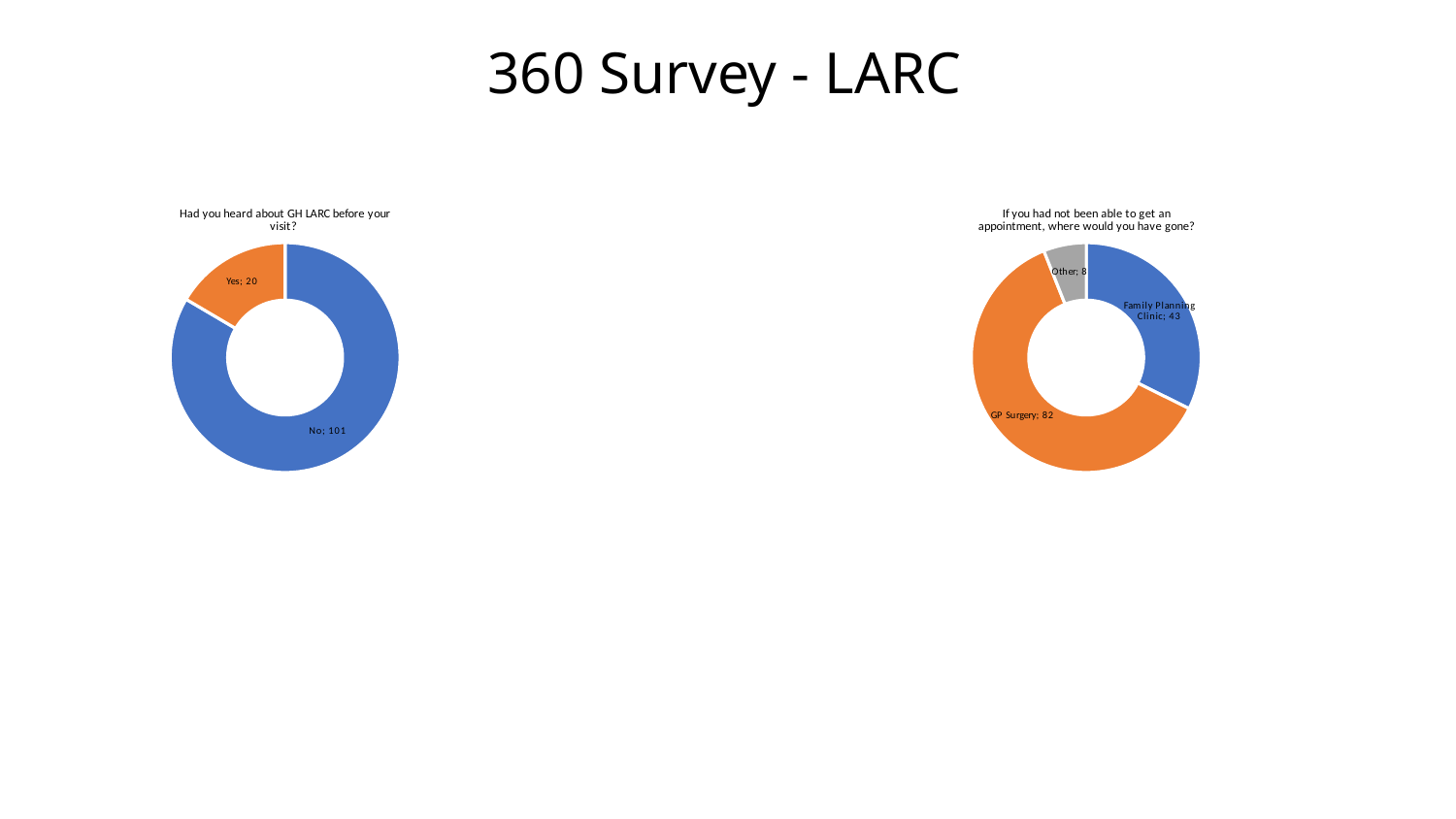
In the chart 'Had you heard about GH LARC before your visit?', what is the total number of responses shown? 121 In the chart 'Had you heard about GH LARC before your visit?', how many respondents answered Yes? 20 In the chart 'If you had not been able to get an appointment, where would you have gone?', what is the value for GP Surgery? 82 In the chart 'Had you heard about GH LARC before your visit?', how many respondents answered No? 101 In the chart 'If you had not been able to get an appointment, where would you have gone?', what is the value for Family Planning Clinic? 43 In the right-hand chart, what colour is the GP Surgery segment? Orange What kind of chart is used for 'Had you heard about GH LARC before your visit?' Doughnut (pie) chart In the chart 'Had you heard about GH LARC before your visit?', what is the difference between the No and Yes counts? 81 In the chart 'Had you heard about GH LARC before your visit?', which response has the larger count? No In the chart 'If you had not been able to get an appointment, where would you have gone?', which category has the smallest value? Other In the chart 'If you had not been able to get an appointment, where would you have gone?', what is the difference between GP Surgery and Family Planning Clinic? 39 In the chart 'If you had not been able to get an appointment, where would you have gone?', how many categories are shown? 3